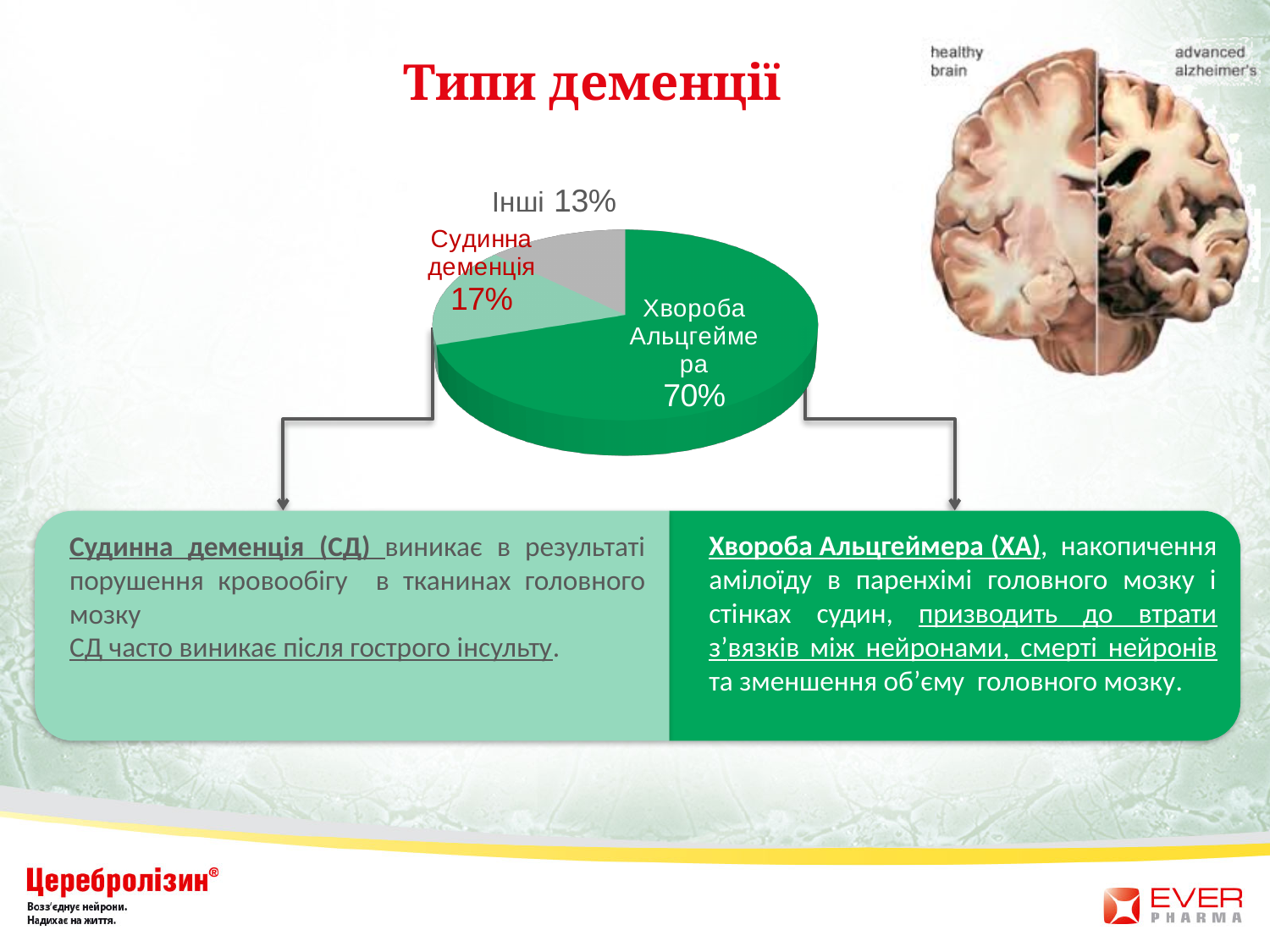
What kind of chart is shown on the slide? Pie chart What is the title of the slide containing the chart? Типи деменції What share of the pie does Хвороба Альцгеймера account for? 70% What share of the pie does Судинна деменція account for? 17% What is the difference in percentage points between Хвороба Альцгеймера and Судинна деменція? 53 Which slice of the pie is the smallest? Інші Which slice of the pie is the largest? Хвороба Альцгеймера What share of the pie does Інші account for? 13% How many slices does the pie chart have? 3 What colour is the Інші slice of the pie? Grey What is the difference in percentage points between Судинна деменція and Інші? 4 Which is larger, the share for Судинна деменція or the share for Інші? Судинна деменція